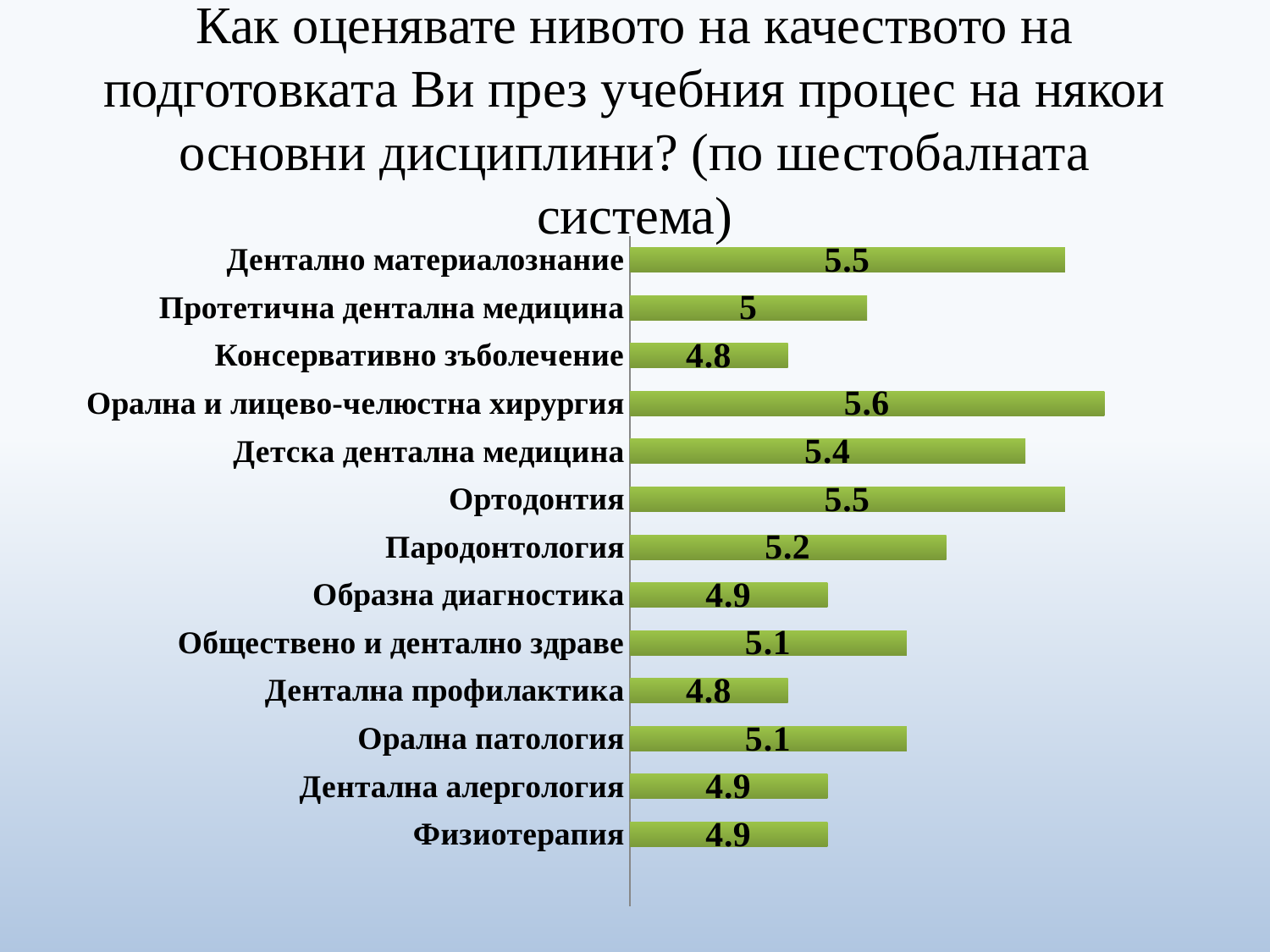
Which has a larger value, Пародонтология or Образна диагностика? Пародонтология How many disciplines (categories) are shown in the chart? 13 Which discipline has the highest value? Орална и лицево-челюстна хирургия What is the value for Дентално материалознание? 5.5 What is the value for Физиотерапия? 4.9 What is the difference between the values for Детска дентална медицина and Обществено и дентално здраве? 0.3 What type of chart is shown on the slide? bar chart What is the difference between the values for Орална и лицево-челюстна хирургия and Консервативно зъболечение? 0.8 What colour are the bars in the chart? green What is the lowest value shown in the chart? 4.8 What is the value for Пародонтология? 5.2 What is the value for Протетична дентална медицина? 5